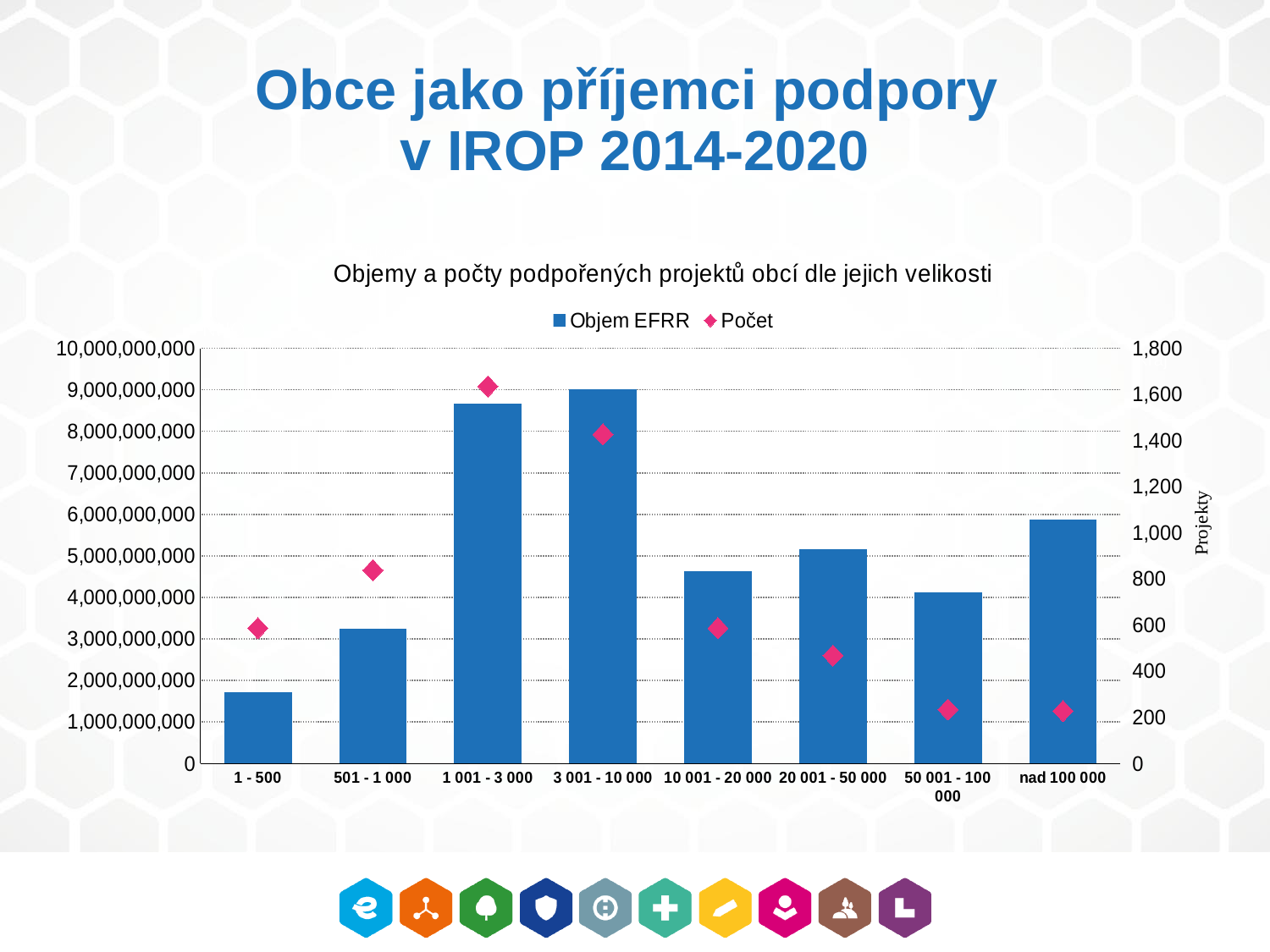
How many size categories are shown on the x axis of the chart? 8 Which has the larger Objem EFRR bar: 20 001 - 50 000 or 50 001 - 100 000? 20 001 - 50 000 Which category has the shortest Objem EFRR bar? 1 - 500 How many series does the chart legend list? 2 Which has the higher Počet value: 3 001 - 10 000 or 10 001 - 20 000? 3 001 - 10 000 Which category has the highest Počet marker? 1 001 - 3 000 Which category has the tallest Objem EFRR bar? 3 001 - 10 000 Is the Počet value for 20 001 - 50 000 greater or less than 600? less Is the Objem EFRR value for 501 - 1 000 greater or less than 3,000,000,000? greater Is the Objem EFRR value for 10 001 - 20 000 greater or less than 4,000,000,000? greater What is the title of the right-hand vertical axis? Projekty